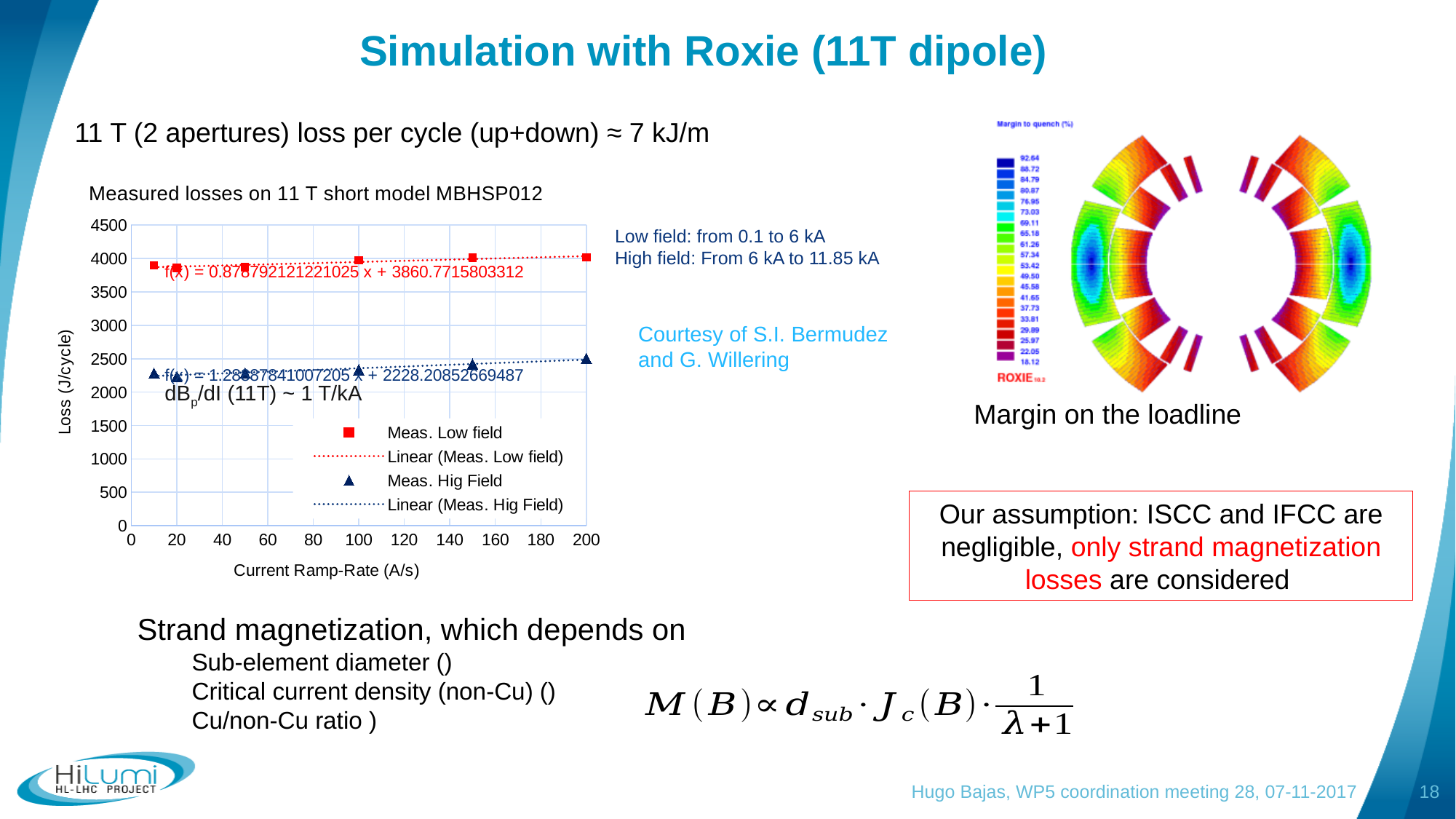
What is the label of the x axis in the 'Measured losses' chart? Current Ramp-Rate (A/s) In the 'Measured losses' chart, is the Meas. Hig Field value at a ramp rate of 10 A/s greater or less than 2000 J/cycle? greater What is the label of the y axis in the 'Measured losses' chart? Loss (J/cycle) In the 'Measured losses' chart, do the Meas. Hig Field losses rise or fall as the current ramp rate increases? rise In the 'Measured losses' chart, is the Meas. Hig Field value at a ramp rate of 200 A/s greater or less than 3000 J/cycle? less In the 'Measured losses' chart, at a ramp rate of 200 A/s, which series has the larger loss: Meas. Low field or Meas. Hig Field? Meas. Low field In the 'Measured losses' chart, what is the highest tick value shown on the y axis? 4500 In the 'Measured losses' chart, how many data points are plotted for the Meas. Hig Field series? 6 What kind of chart is 'Measured losses on 11 T short model MBHSP012'? scatter chart In the 'Measured losses' chart, is the Meas. Low field value at a ramp rate of 200 A/s greater or less than 3500 J/cycle? greater In the 'Measured losses' chart, how many data points are plotted for the Meas. Low field series? 6 How many entries does the legend of the 'Measured losses on 11 T short model MBHSP012' chart list? 4